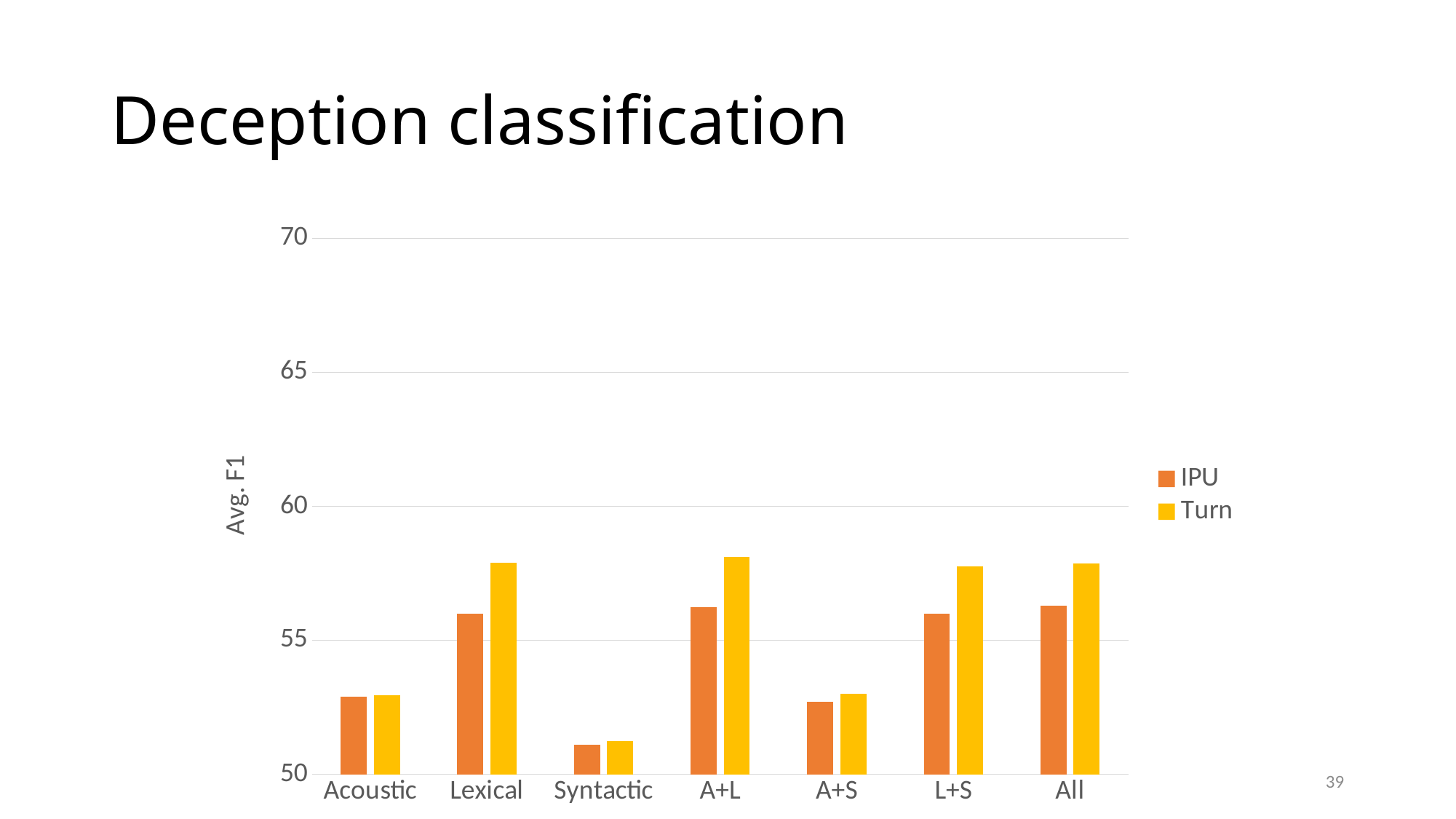
Is the Turn value for A+L greater or less than 60? less For Lexical, which series has the higher Avg. F1, IPU or Turn? Turn How many feature-set categories are shown on the x axis? 7 Is the IPU value for Syntactic greater or less than 55? less What is the label on the vertical axis? Avg. F1 What kind of chart is shown on the slide? bar chart Which category has the lowest Avg. F1 for the Turn series? Syntactic Is the Turn value for Lexical greater or less than 55? greater How many series does the legend list? 2 For the IPU series, which is higher, Acoustic or Syntactic? Acoustic Which category has the lowest Avg. F1 for the IPU series? Syntactic